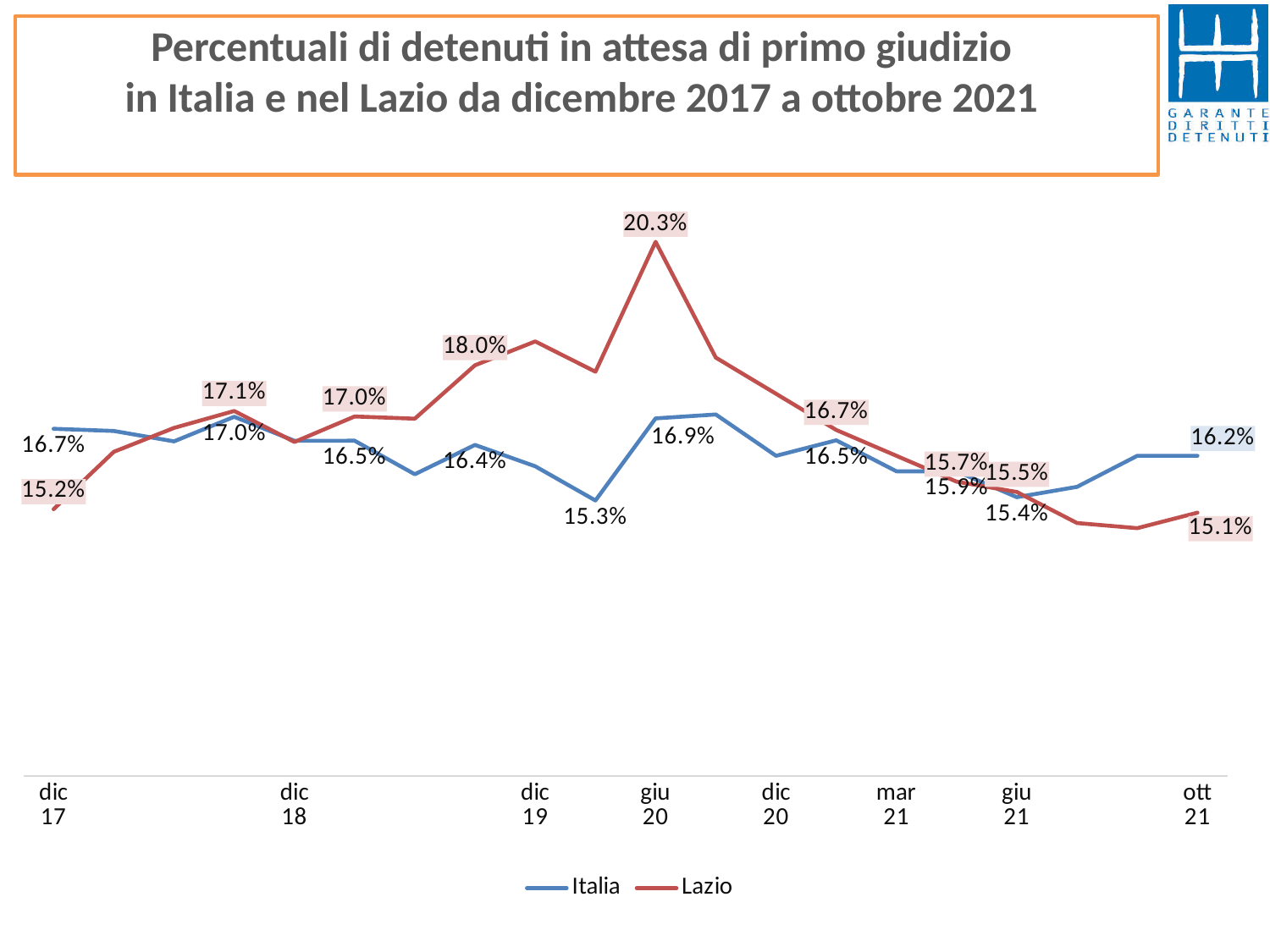
What is the value for Lazio at giu 20? 20.3% What is the highest value reached by the Lazio series? 20.3% What is the value for Italia at dic 17? 16.7% What type of chart is shown on the slide? line chart What is the lowest value labelled on the Italia series? 15.3% How many series does the legend list? 2 What is the value for Lazio at dic 17? 15.2% Which colour is used for the Lazio series? red What is the value for Italia at ott 21? 16.2% Which series has the higher value at dic 17, Italia or Lazio? Italia What is the value for Lazio at ott 21? 15.1% What is the difference between the Italia and Lazio values at ott 21? 1.1 percentage points